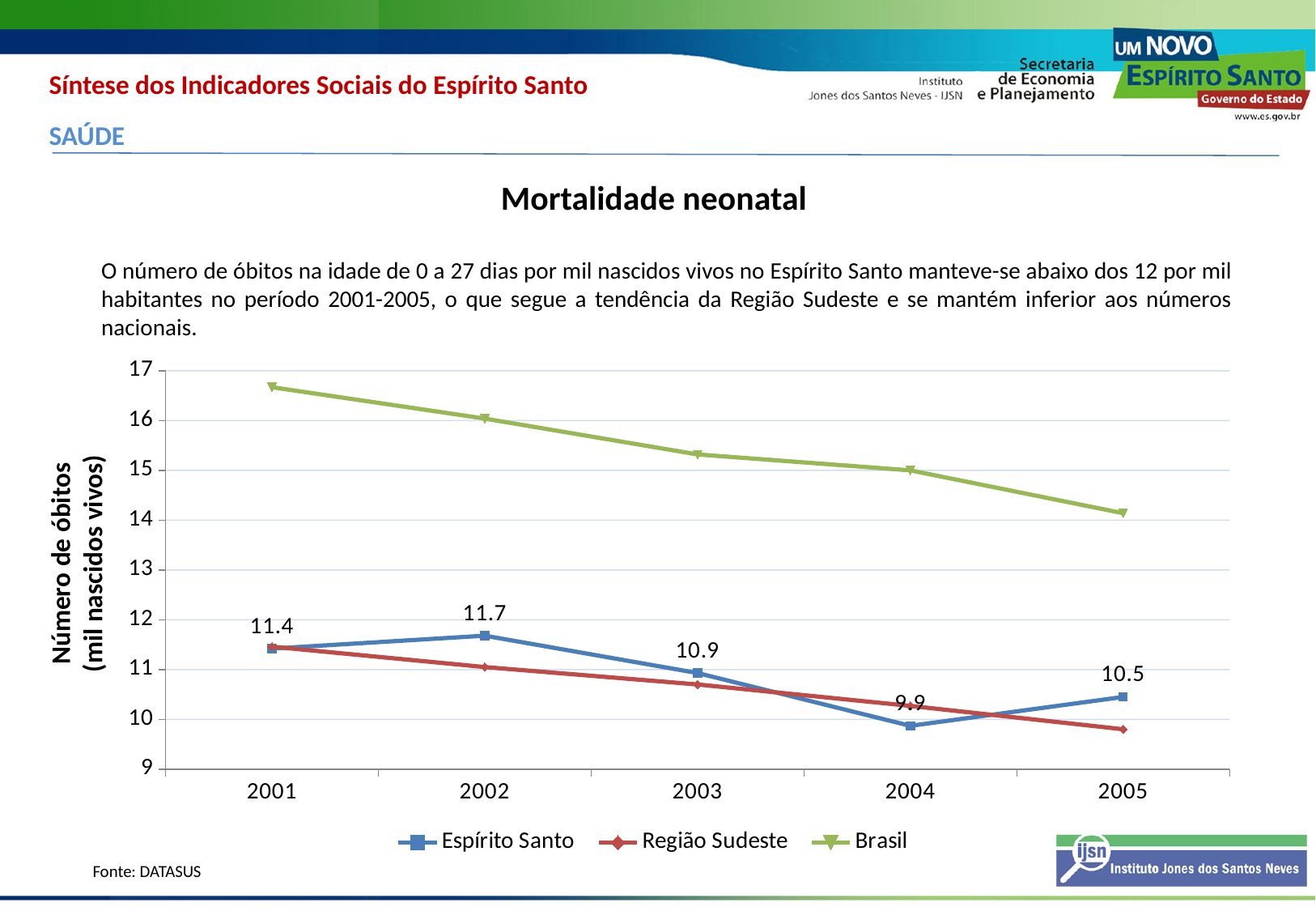
Is the value for Brasil in 2001 greater or less than 16? greater How many years are shown on the x axis? 5 What is the difference between the Espírito Santo values for 2001 and 2005? 0.9 Is the value for Brasil in 2005 greater or less than 15? less What is the difference between the Espírito Santo values for 2002 and 2004? 1.8 What is the value for Espírito Santo in 2002? 11.7 In which year is the Espírito Santo series highest? 2002 In which year is the Espírito Santo series lowest? 2004 In 2001, which series has the larger value: Brasil or Espírito Santo? Brasil What is the value for Espírito Santo in 2004? 9.9 What kind of chart is shown on the slide? line chart How many series does the legend list? 3